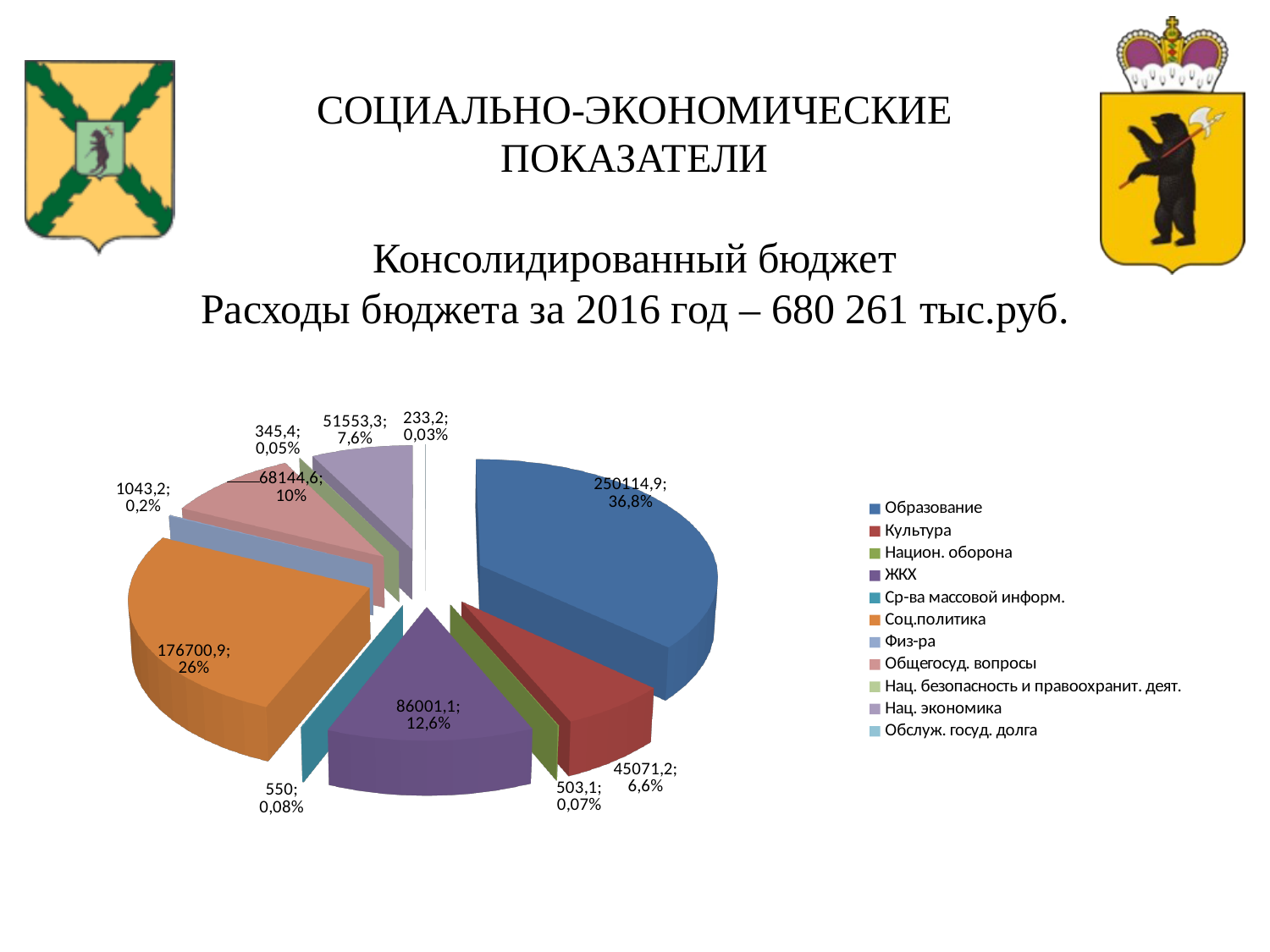
What value is shown for the Культура slice? 45071,2 What total budget expenditure for 2016 is stated in the slide title? 680 261 тыс.руб. What kind of chart is shown on the slide? pie chart How many categories does the legend of the pie chart list? 11 Which is larger, the Соц.политика slice or the Общегосуд. вопросы slice? Соц.политика What percentage is shown for the Нац. экономика slice? 7,6% What share of the pie does Образование (education) account for? 36,8% What percentage is shown for the ЖКХ slice? 12,6% What value is shown for the Соц.политика slice? 176700,9 Which category has the largest slice of the pie? Образование What is the difference between the Образование value (250114,9) and the Соц.политика value (176700,9)? 73414 Which category has the smallest slice of the pie? Обслуж. госуд. долга